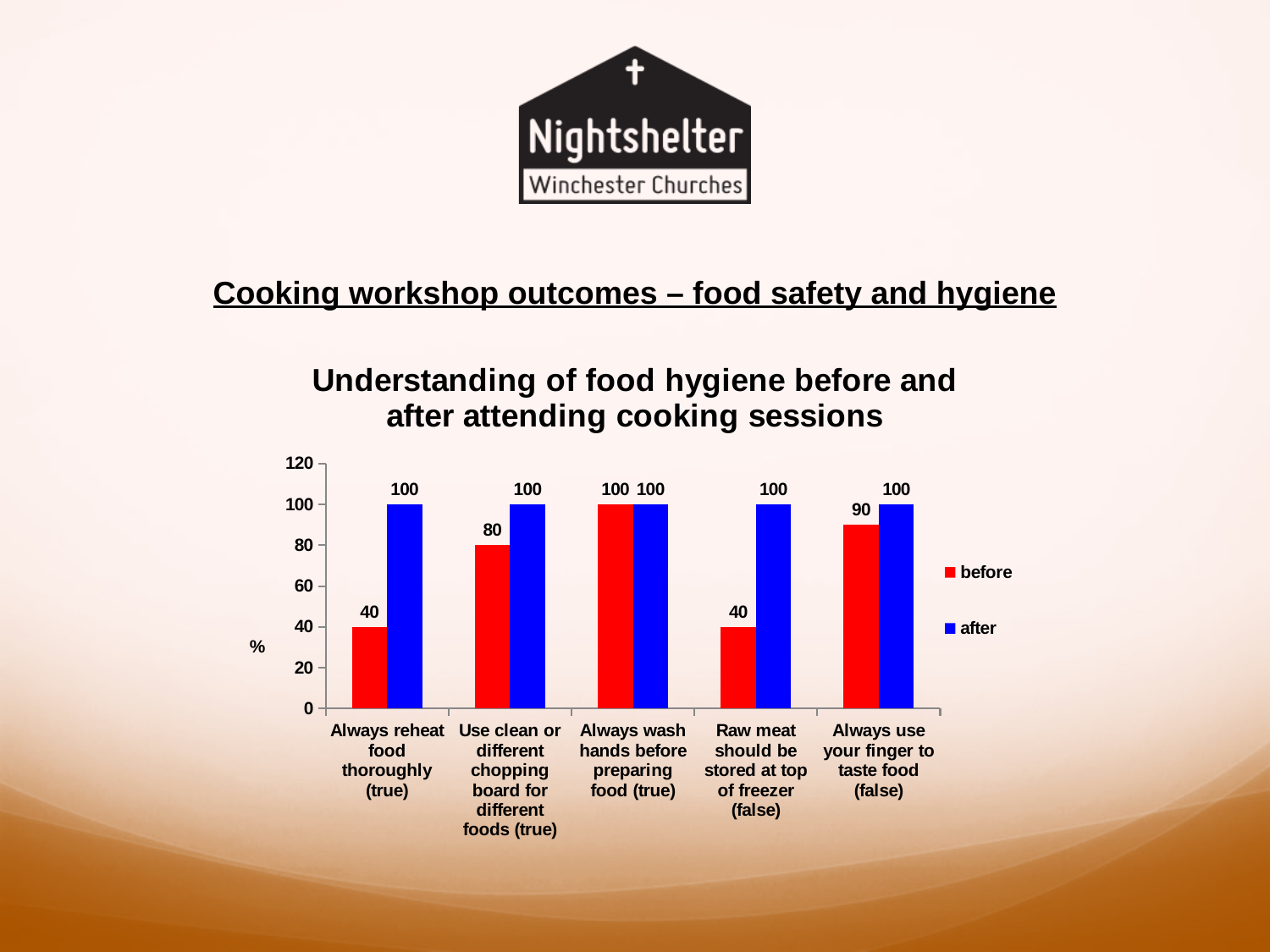
What is the 'before' value for 'Always reheat food thoroughly (true)'? 40 What is the 'after' value for 'Raw meat should be stored at top of freezer (false)'? 100 What is the difference between the 'after' and 'before' values for 'Use clean or different chopping board for different foods (true)'? 20 What is the title of the chart? Understanding of food hygiene before and after attending cooking sessions How many categories are shown on the x axis? 5 What kind of chart is shown on the slide? Bar chart Which is larger: the 'before' value for 'Always use your finger to taste food (false)' or the 'before' value for 'Raw meat should be stored at top of freezer (false)'? Always use your finger to taste food (false) What is the 'before' value for 'Always use your finger to taste food (false)'? 90 Which category has the highest 'before' value? Always wash hands before preparing food (true) What is the difference between the 'after' and 'before' values for 'Always reheat food thoroughly (true)'? 60 What is the 'before' value for 'Use clean or different chopping board for different foods (true)'? 80 How many series does the legend list? 2